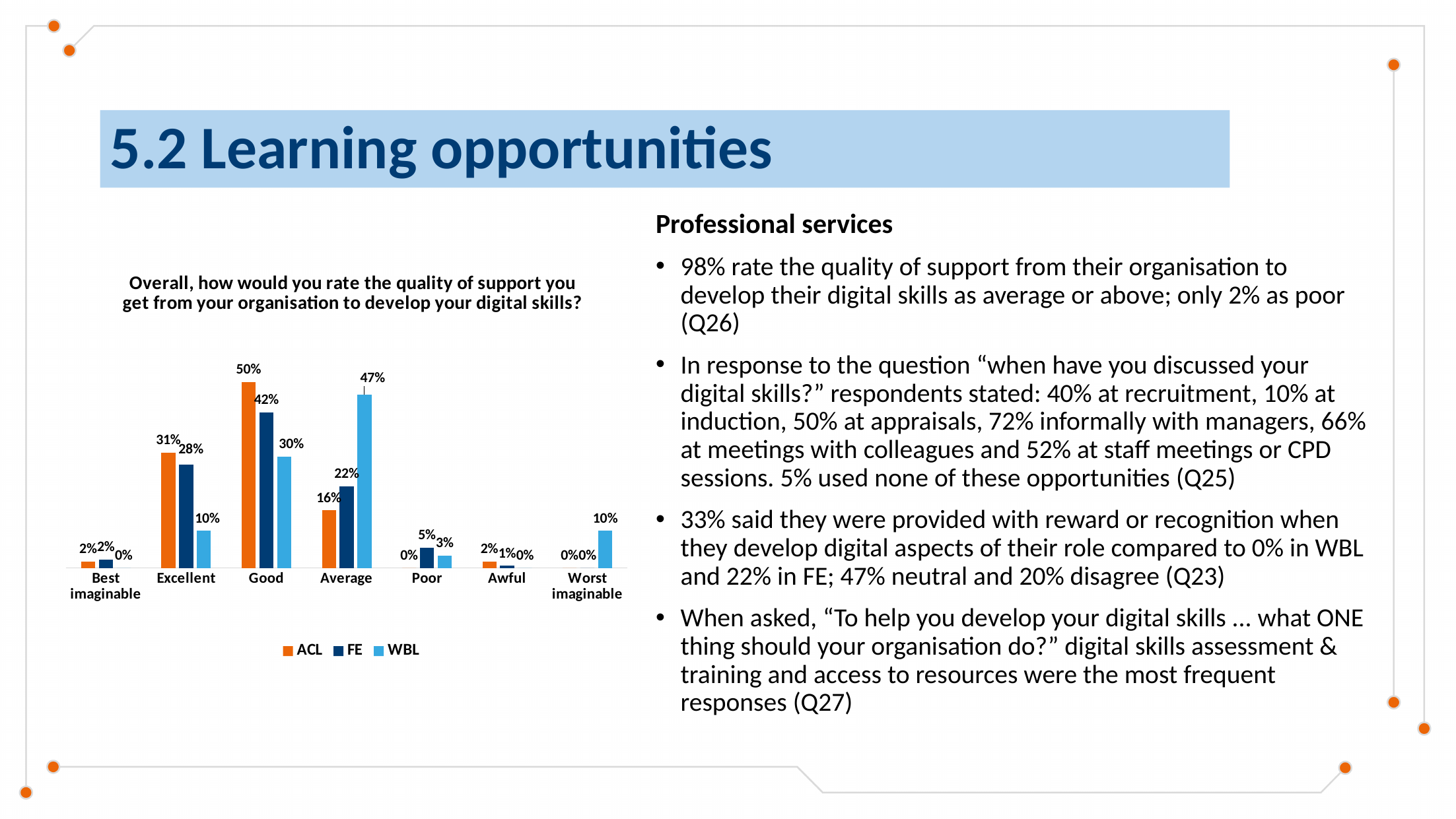
What percentage of WBL respondents rated the quality of support as Worst imaginable? 10% Which series is shown in orange in the chart's legend? ACL For the Average rating, which series has the larger value, ACL or FE? FE How many series does the chart's legend list? 3 What type of chart is shown on the slide? Bar chart Which rating category has the highest value for the ACL series? Good What percentage of WBL respondents rated the quality of support as Average? 47% What is the difference between the ACL and WBL values for the Excellent rating? 21% What percentage of ACL respondents rated the quality of support as Good? 50% What percentage of FE respondents rated the quality of support as Excellent? 28% How many rating categories are shown on the x axis of the chart? 7 Which rating category has the highest value for the WBL series? Average